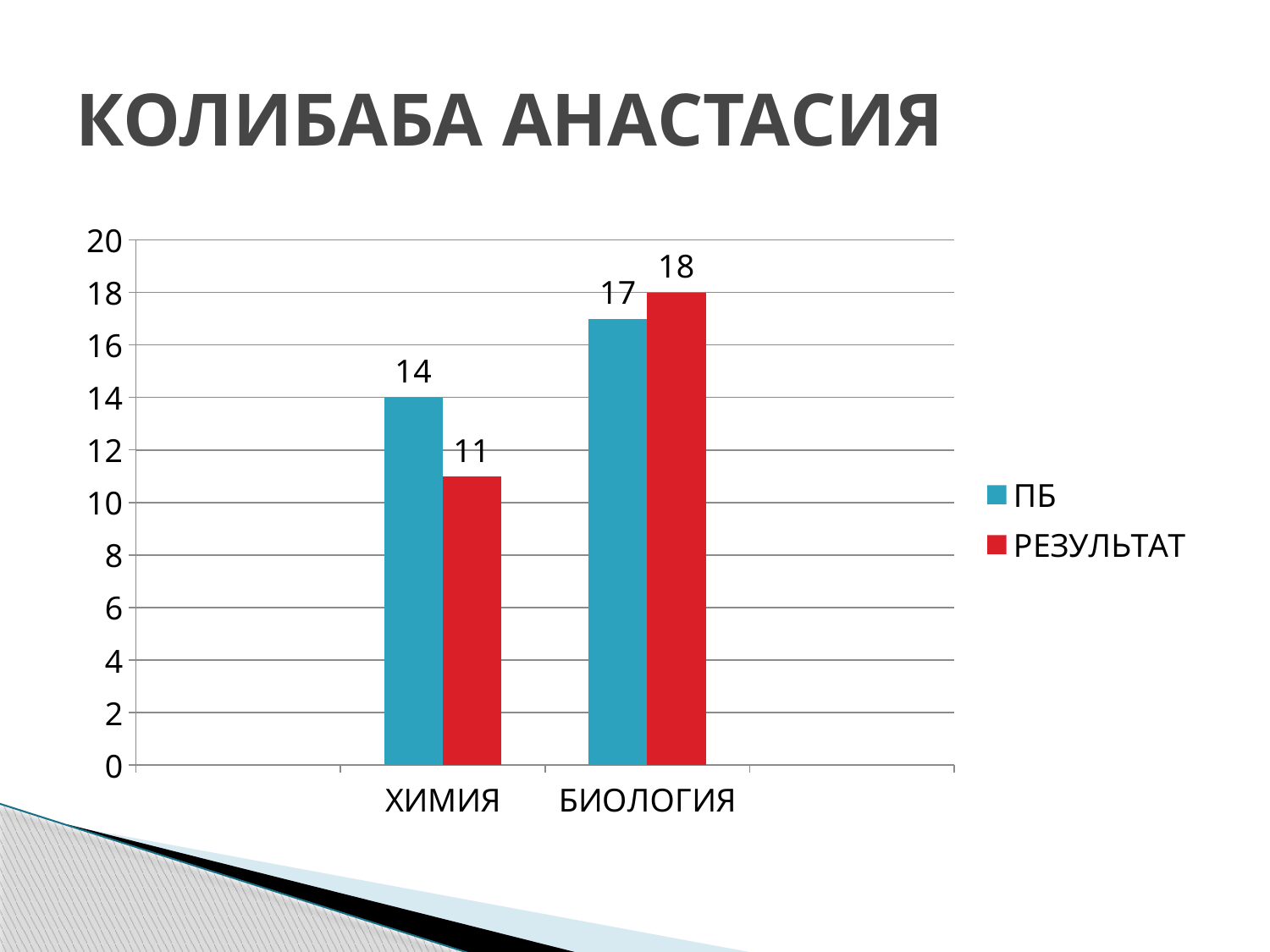
What is the РЕЗУЛЬТАТ value for БИОЛОГИЯ? 18 What is the difference between the РЕЗУЛЬТАТ values for БИОЛОГИЯ and ХИМИЯ? 7 How many series does the legend list? 2 What kind of chart is shown on the slide? Bar chart How many categories are shown on the x axis? 2 What is the ПБ value for БИОЛОГИЯ? 17 Which category has the lowest ПБ value? ХИМИЯ Which category has the highest РЕЗУЛЬТАТ value? БИОЛОГИЯ What is the ПБ value for ХИМИЯ? 14 For БИОЛОГИЯ, which is larger: ПБ or РЕЗУЛЬТАТ? РЕЗУЛЬТАТ What is the difference between the ПБ and РЕЗУЛЬТАТ values for ХИМИЯ? 3 What is the РЕЗУЛЬТАТ value for ХИМИЯ? 11